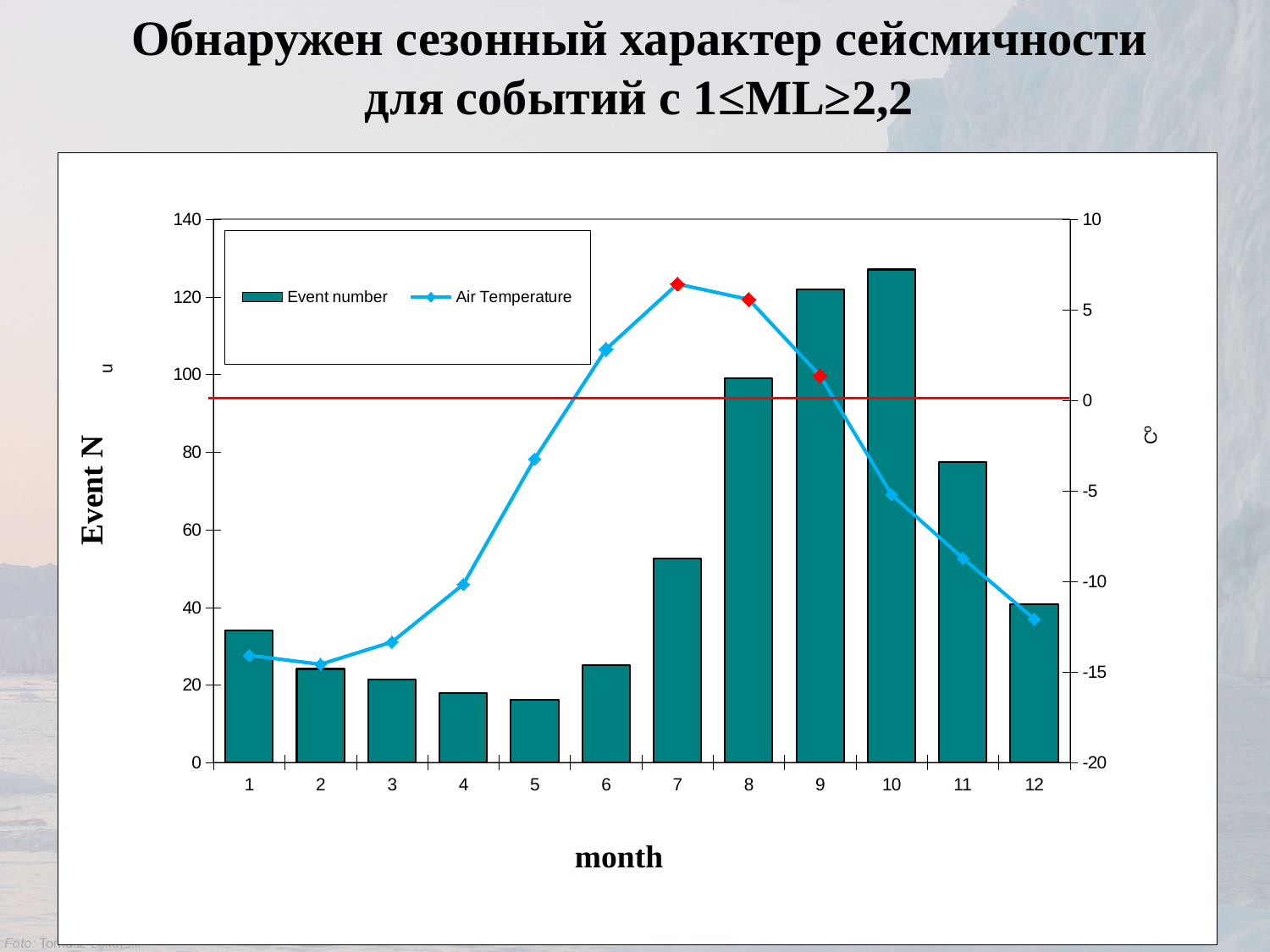
In which month is the Event number highest? 10 In which month is the Event number lowest? 5 Does the Air Temperature rise or fall from month 7 to month 12? fall Is the Event number for month 8 greater or less than 80? greater Is the Air Temperature for month 10 greater or less than 0? less What kind of chart is used for the Event number series? Bar chart How many series does the chart legend list? 2 How many months (categories) are shown on the x axis of the chart? 12 In which month does the Air Temperature reach its highest value? 7 Is the Event number for month 7 greater or less than 60? less Which month has a larger Event number, month 9 or month 11? 9 What are the two series named in the chart legend? Event number and Air Temperature